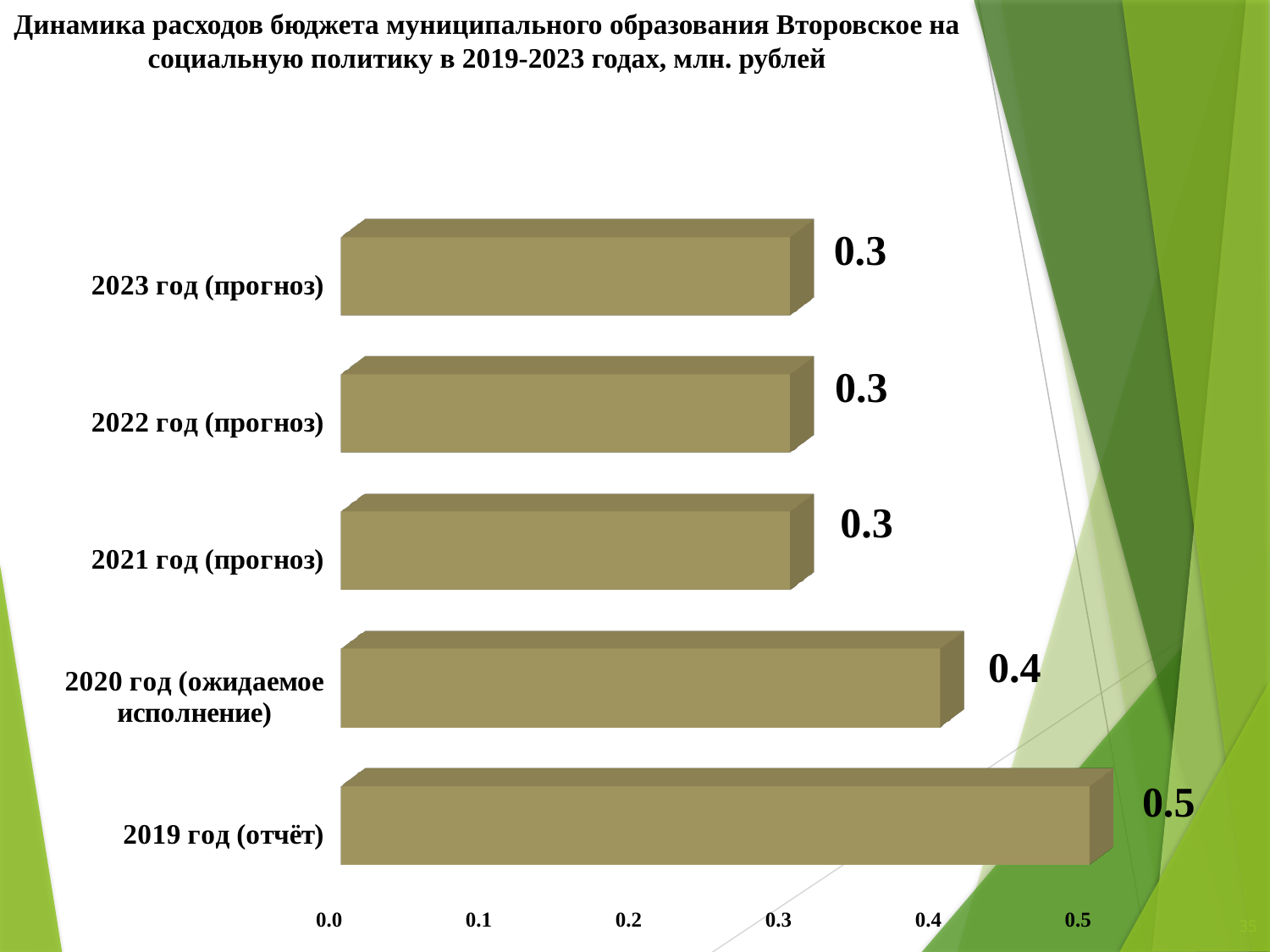
What is the value for 2019 год (отчёт)? 0.5 What is the value for 2021 год (прогноз)? 0.3 What kind of chart is shown on the slide? bar chart What is the difference between the values for 2019 год (отчёт) and 2020 год (ожидаемое исполнение)? 0.1 Is the value for 2019 год (отчёт) greater or less than 0.4? greater Which category has the highest value? 2019 год (отчёт) What is the value for 2020 год (ожидаемое исполнение)? 0.4 What unit of measurement is stated in the chart title? млн. рублей What is the difference between the values for 2019 год (отчёт) and 2023 год (прогноз)? 0.2 How many categories are shown in the chart? 5 Which is larger, the value for 2020 год (ожидаемое исполнение) or the value for 2022 год (прогноз)? 2020 год (ожидаемое исполнение) What is the value for 2023 год (прогноз)? 0.3